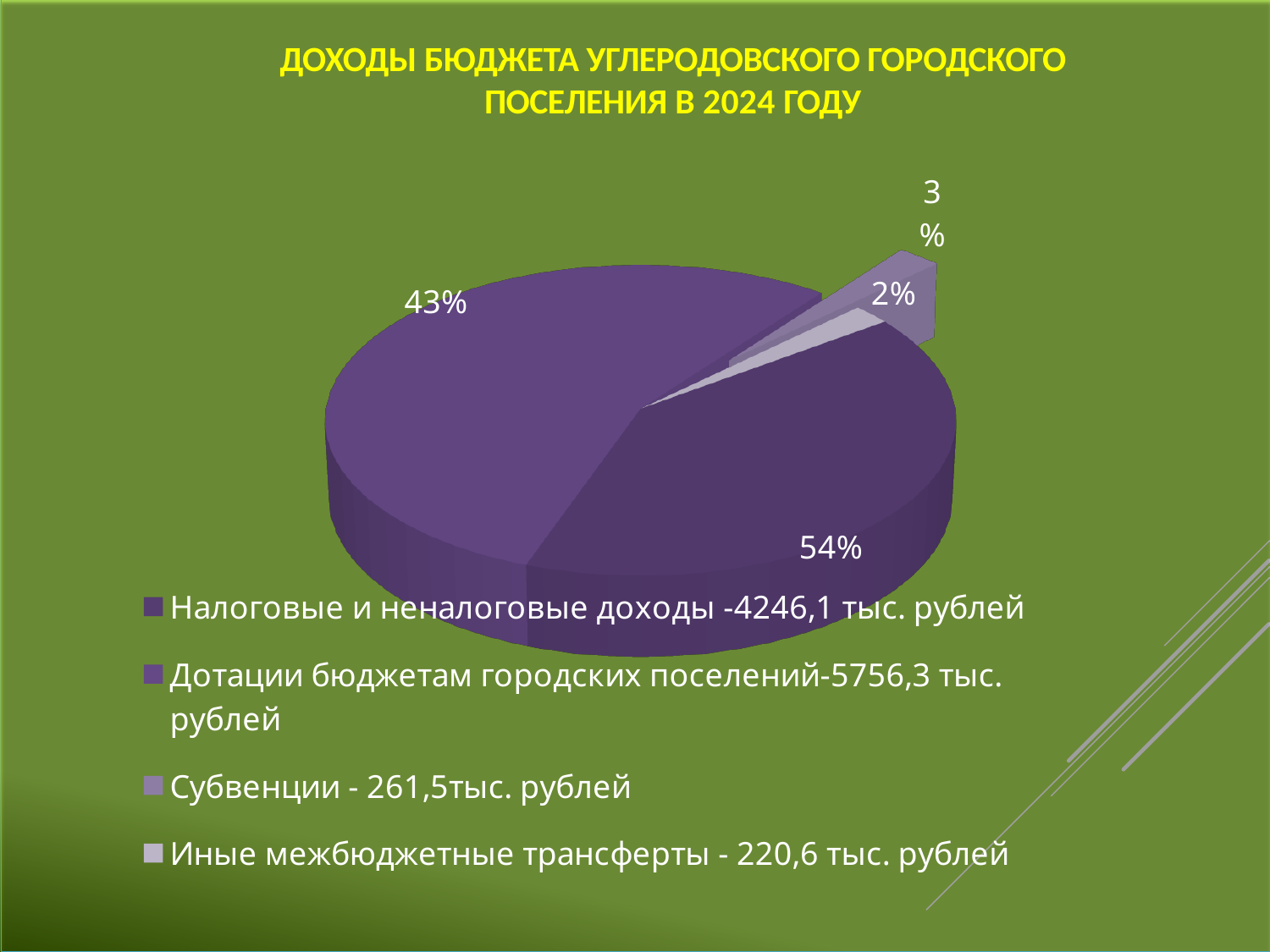
Which category has the largest slice of the pie? Дотации бюджетам городских поселений Which is larger: the Субвенции slice or the Иные межбюджетные трансферты slice? Субвенции What is the difference in percentage points between the Дотации slice and the Налоговые и неналоговые доходы slice? 11 What share of the pie is labelled for Иные межбюджетные трансферты? 2% How many entries does the legend list? 4 Which category has the smallest slice of the pie? Иные межбюджетные трансферты What share of the pie is labelled for Налоговые и неналоговые доходы? 43% What share of the pie is labelled for Дотации бюджетам городских поселений? 54% What kind of chart is shown on the slide? pie chart How many slices does the pie chart have? 4 What amount in тыс. рублей does the legend give for Субвенции? 261,5